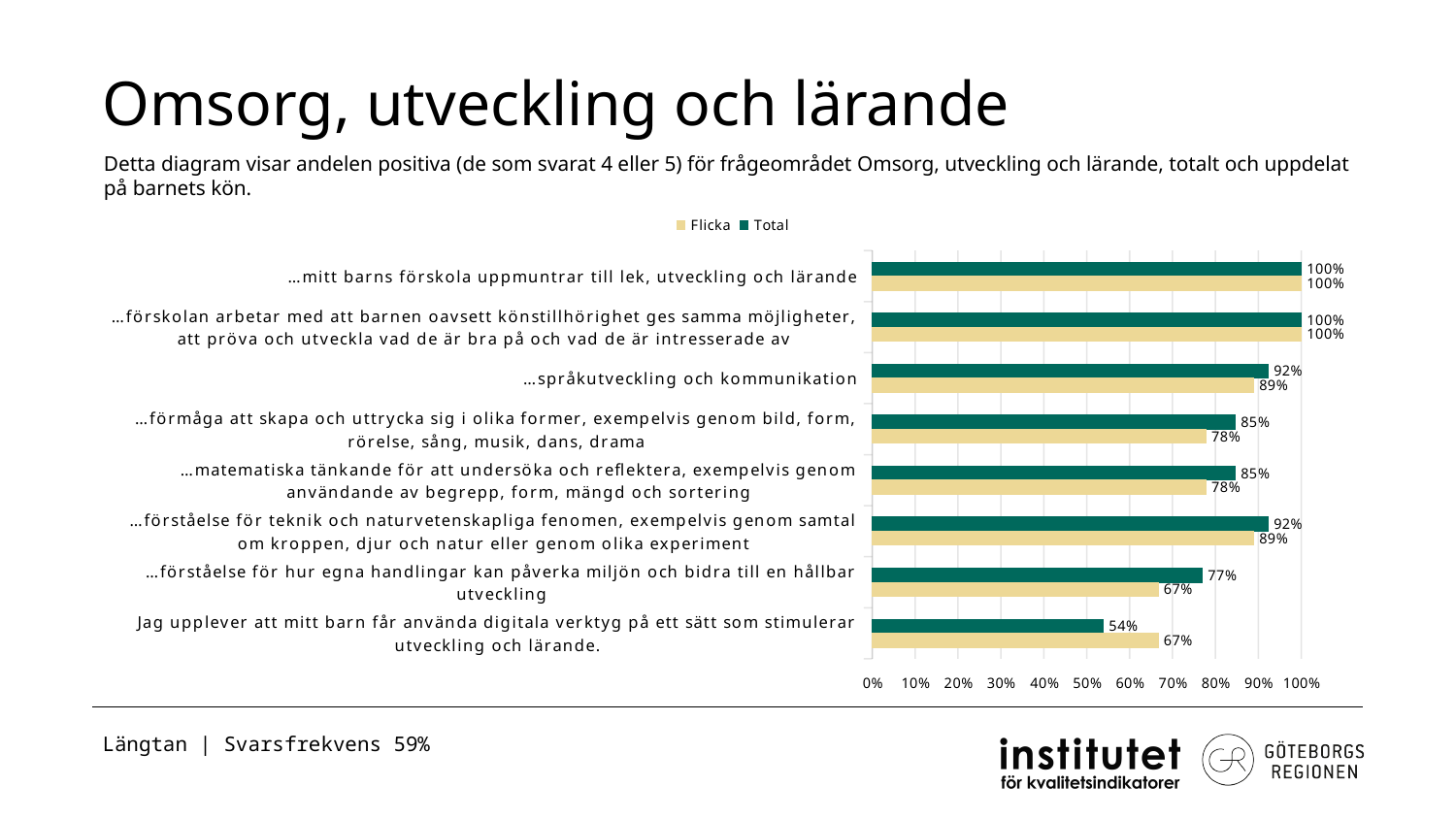
How many categories are shown in the chart? 8 What kind of chart is shown on the slide? Bar chart What is the Total value for "…språkutveckling och kommunikation"? 92% Which category has the lowest Total value? Jag upplever att mitt barn får använda digitala verktyg på ett sätt som stimulerar utveckling och lärande. How many series does the legend list? 2 For "…matematiska tänkande för att undersöka och reflektera, exempelvis genom användande av begrepp, form, mängd och sortering", which is larger, the Flicka value or the Total value? Total For "Jag upplever att mitt barn får använda digitala verktyg på ett sätt som stimulerar utveckling och lärande.", which is larger, the Flicka value or the Total value? Flicka What is the Flicka value for "Jag upplever att mitt barn får använda digitala verktyg på ett sätt som stimulerar utveckling och lärande."? 67% What is the difference between the Total and Flicka values for "…förståelse för hur egna handlingar kan påverka miljön och bidra till en hållbar utveckling"? 10 percentage points What is the Total value for "…förståelse för hur egna handlingar kan påverka miljön och bidra till en hållbar utveckling"? 77% Which series is shown in green in the chart? Total What is the difference between the Total and Flicka values for "…förmåga att skapa och uttrycka sig i olika former, exempelvis genom bild, form, rörelse, sång, musik, dans, drama"? 7 percentage points